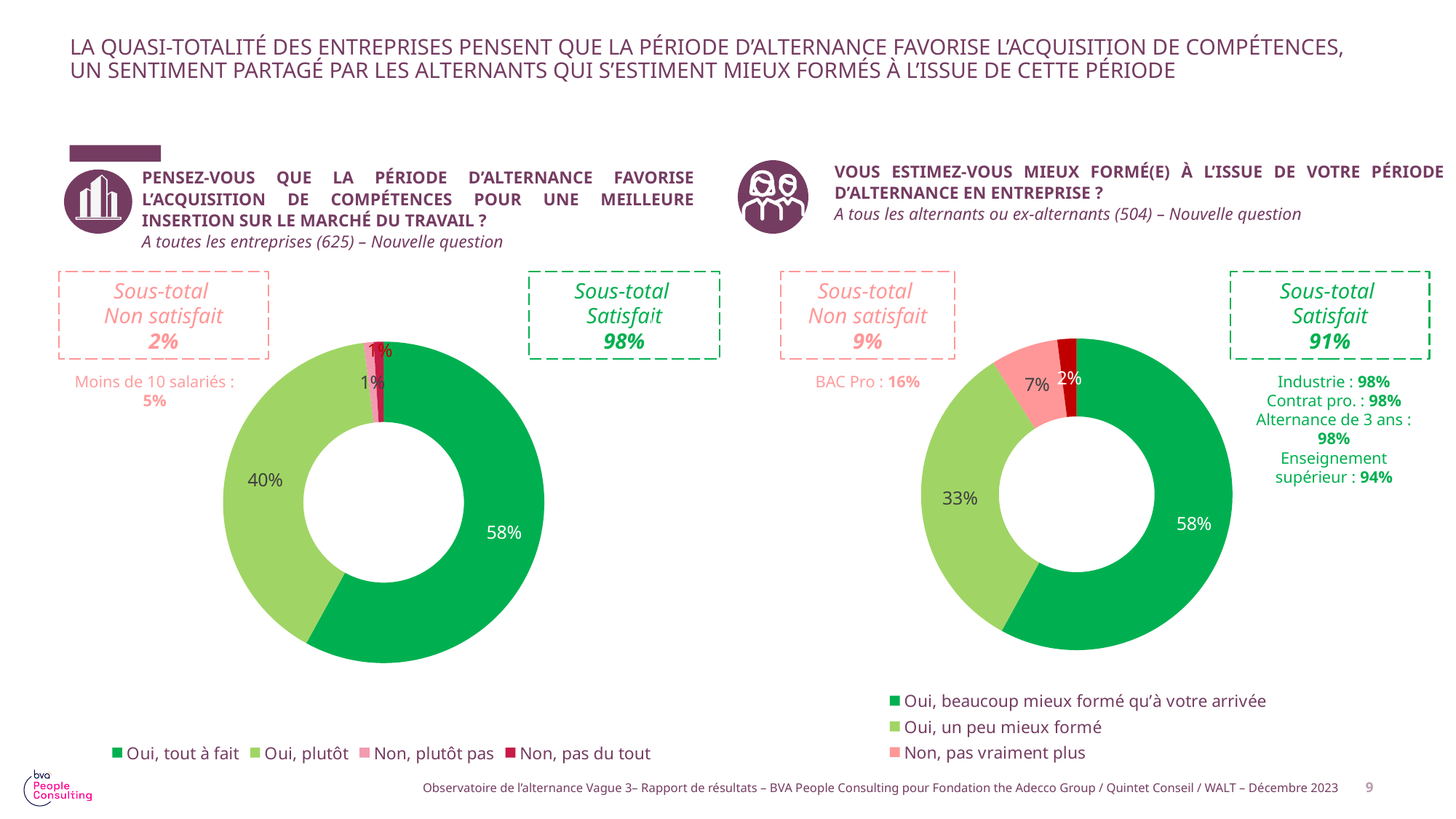
What is the "Sous-total Satisfait" shown next to the right chart? 91% On the left chart, what share of companies answered "Oui, plutôt"? 40% On the right chart, what share of respondents answered "Oui, beaucoup mieux formé qu'à votre arrivée"? 58% How many entries does the legend of the left chart list? 4 On the right chart, what share of respondents answered "Oui, un peu mieux formé"? 33% On the right chart, which is larger: the share for "Oui, un peu mieux formé" or the share for "Non, pas vraiment plus"? Oui, un peu mieux formé On the right chart, what share of respondents answered "Non, pas vraiment plus"? 7% On the left chart, which response category has the largest share? Oui, tout à fait What kind of chart is used on the left side of the slide? Donut (pie) chart On the left chart, what share of companies answered "Oui, tout à fait"? 58% On the left chart, what is the difference between the shares for "Oui, tout à fait" and "Oui, plutôt"? 18% On the left chart, what share of companies answered "Non, plutôt pas"? 1%